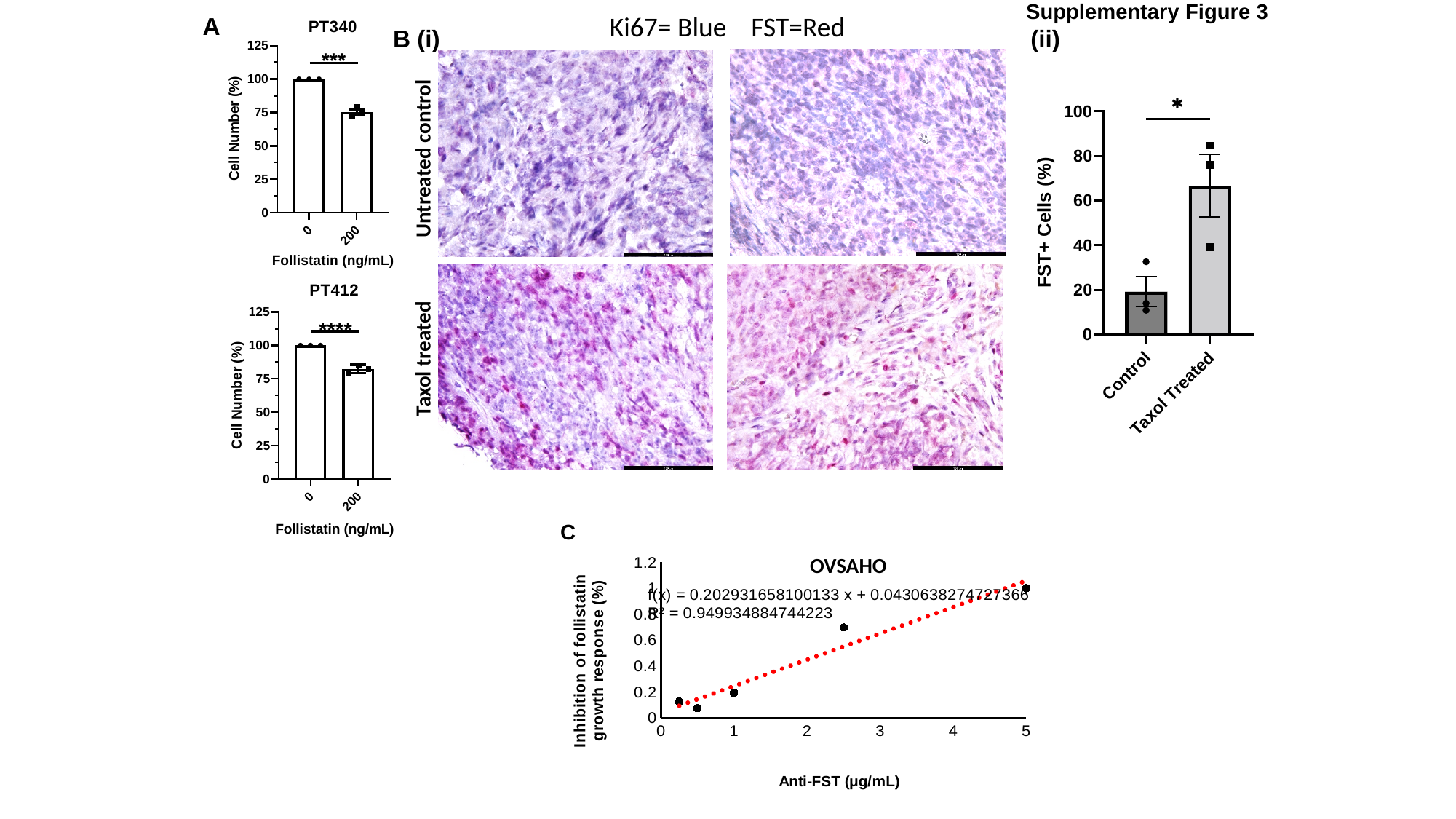
In the PT340 chart, how many Follistatin concentrations (bars) are shown? 2 In the OVSAHO chart, what R² value is printed for the trendline? 0.949934884744223 In the FST+ Cells chart (panel B ii), is the value for Taxol Treated greater or less than 60? greater In the PT412 chart, is the cell number for 200 ng/mL Follistatin greater or less than 75? greater What kind of chart is the OVSAHO chart in panel C? scatter chart In the PT340 chart, is the cell number for 200 ng/mL Follistatin greater or less than 100? less What kind of chart is the PT340 chart in panel A? bar chart In the PT340 chart, which Follistatin concentration has the lower cell number? 200 In the FST+ Cells chart (panel B ii), which group has the higher percentage of FST+ cells? Taxol Treated In the PT412 chart, which Follistatin concentration has the higher cell number? 0 In the OVSAHO chart, does the inhibition of follistatin growth response rise or fall as Anti-FST concentration increases? rise